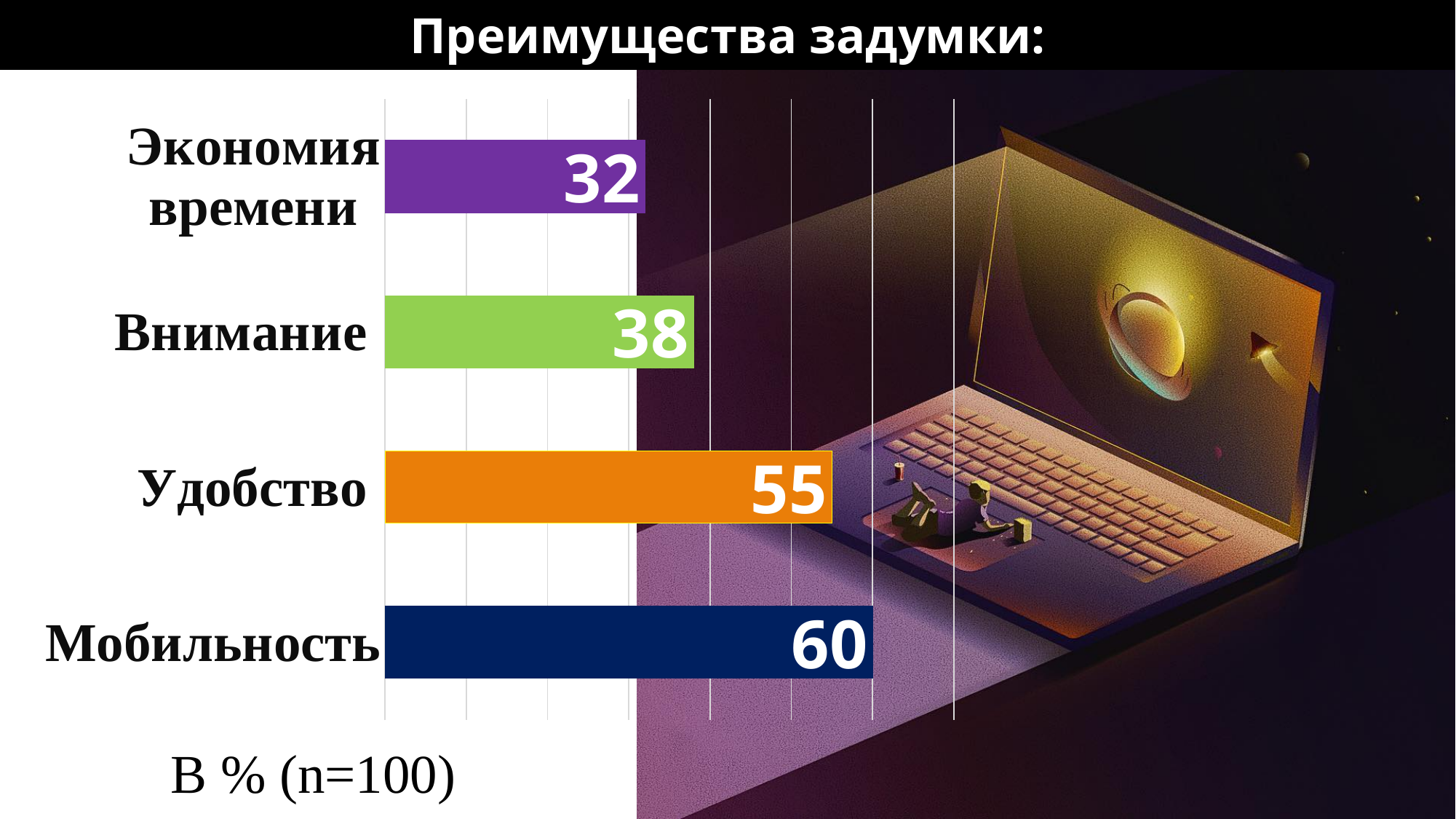
What is the difference between the values for Внимание and Экономия времени? 6 How many categories are shown in the chart? 4 Which category has the highest value? Мобильность Which is larger, the value for Удобство or the value for Внимание? Удобство What is the value for Мобильность? 60 What is the value for Удобство? 55 Which category has the lowest value? Экономия времени What is the value for Экономия времени? 32 What kind of chart is shown on the slide? bar chart What is the difference between the values for Мобильность and Удобство? 5 What is the title of the chart? Преимущества задумки: What is the value for Внимание? 38